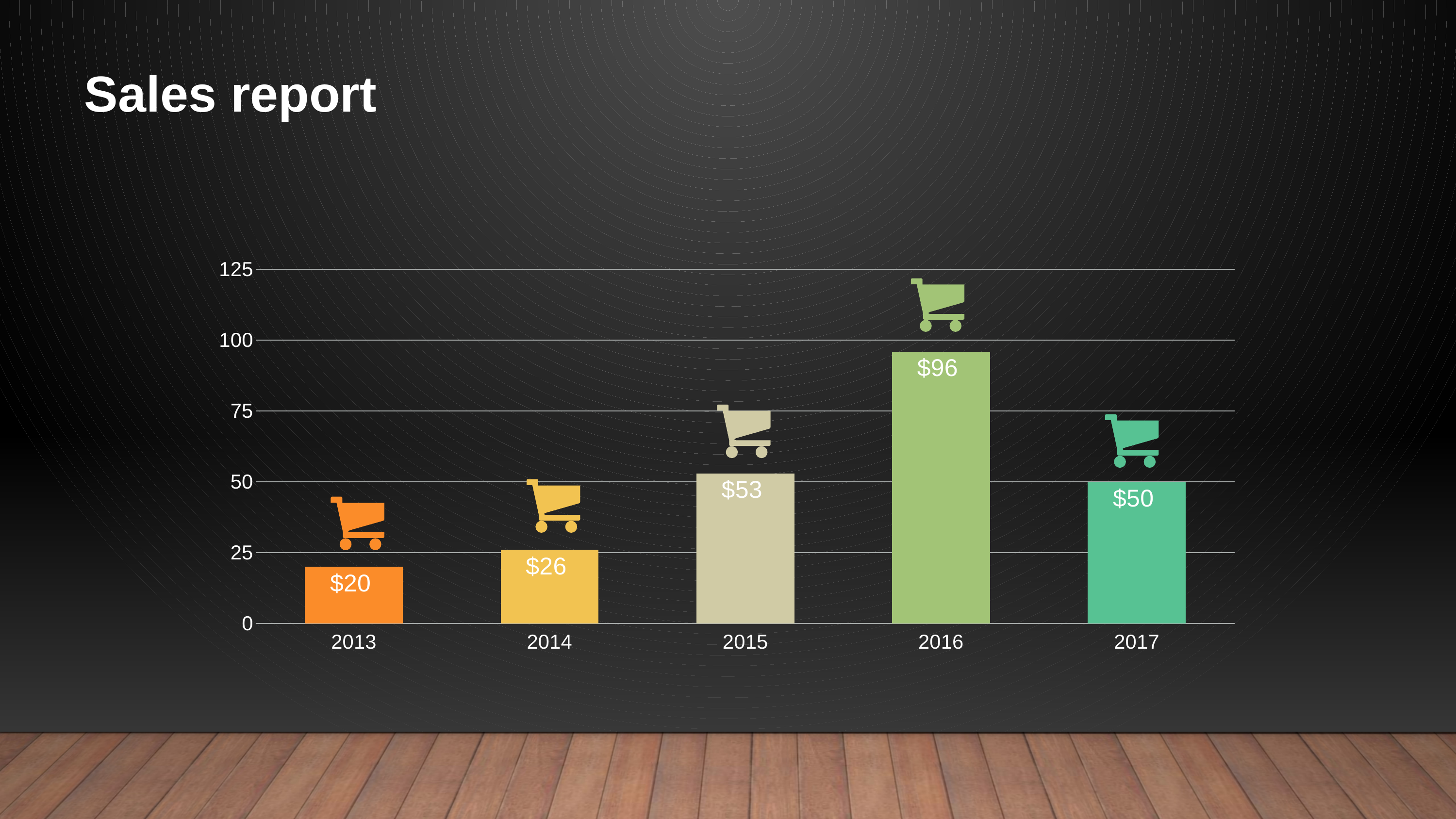
What is the value for 2017? $50 Which is larger, the value for 2015 or the value for 2017? 2015 Is the value for 2016 greater or less than 75? greater What is the value for 2016? $96 What kind of chart is shown on the slide? bar chart How many years are shown on the x axis? 5 What is the difference between the values for 2016 and 2015? $43 Which year has the highest value? 2016 Which year has the lowest value? 2013 What is the title of the slide? Sales report What is the value for 2013? $20 What is the difference between the values for 2014 and 2013? $6